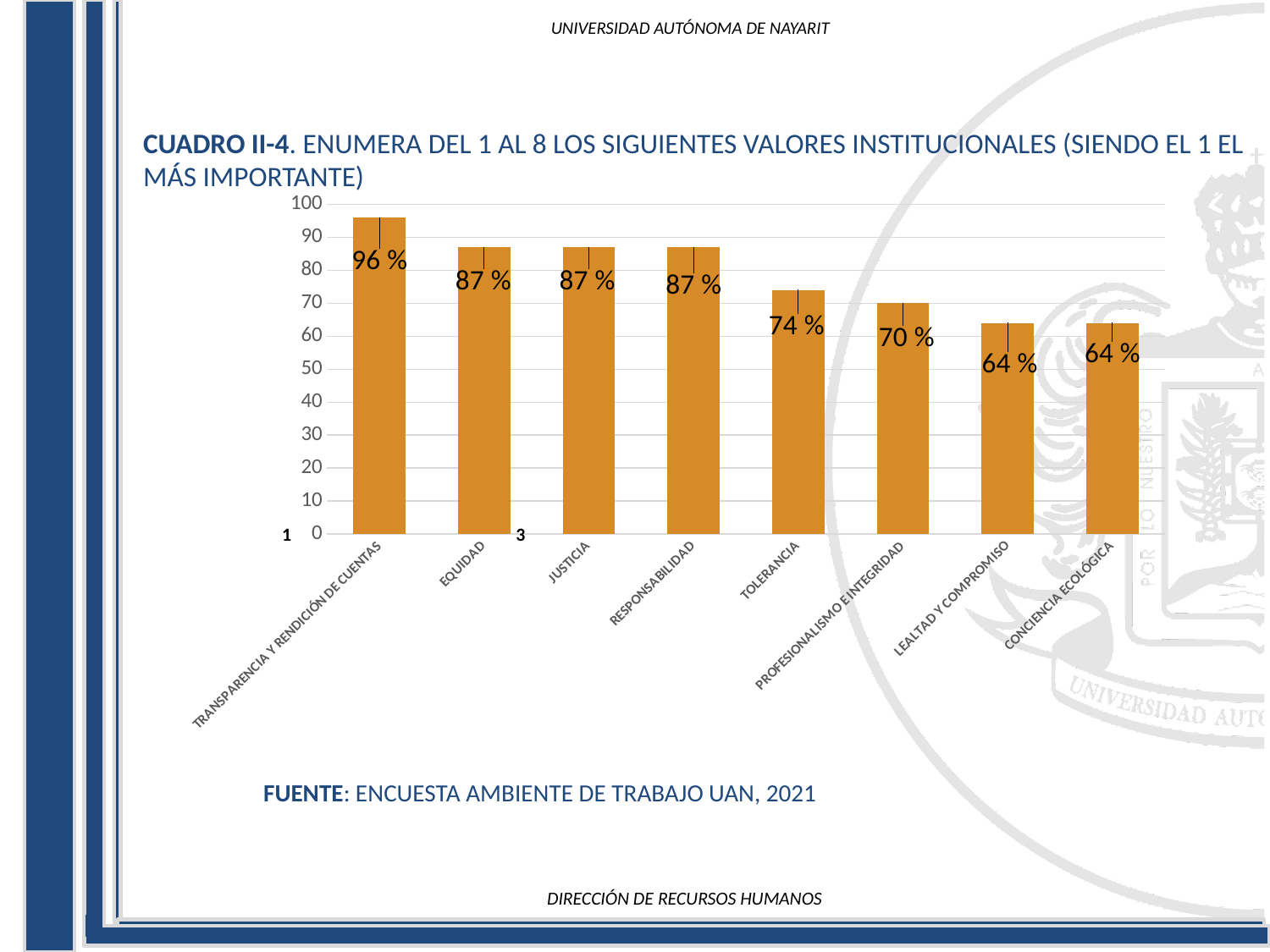
What is the value for CONCIENCIA ECOLÓGICA? 64 % Is the value for PROFESIONALISMO E INTEGRIDAD greater or less than 80? less Which category has the highest value? TRANSPARENCIA Y RENDICIÓN DE CUENTAS What kind of chart is shown on the slide? bar chart What is the difference between the values for TOLERANCIA and LEALTAD Y COMPROMISO? 10 % What is the value for TOLERANCIA? 74 % What is the difference between the values for TRANSPARENCIA Y RENDICIÓN DE CUENTAS and EQUIDAD? 9 % How many categories are shown in the chart? 8 What is the value for PROFESIONALISMO E INTEGRIDAD? 70 % Which is larger, the value for JUSTICIA or the value for TOLERANCIA? JUSTICIA What is the source cited below the chart? ENCUESTA AMBIENTE DE TRABAJO UAN, 2021 What is the value for TRANSPARENCIA Y RENDICIÓN DE CUENTAS? 96 %